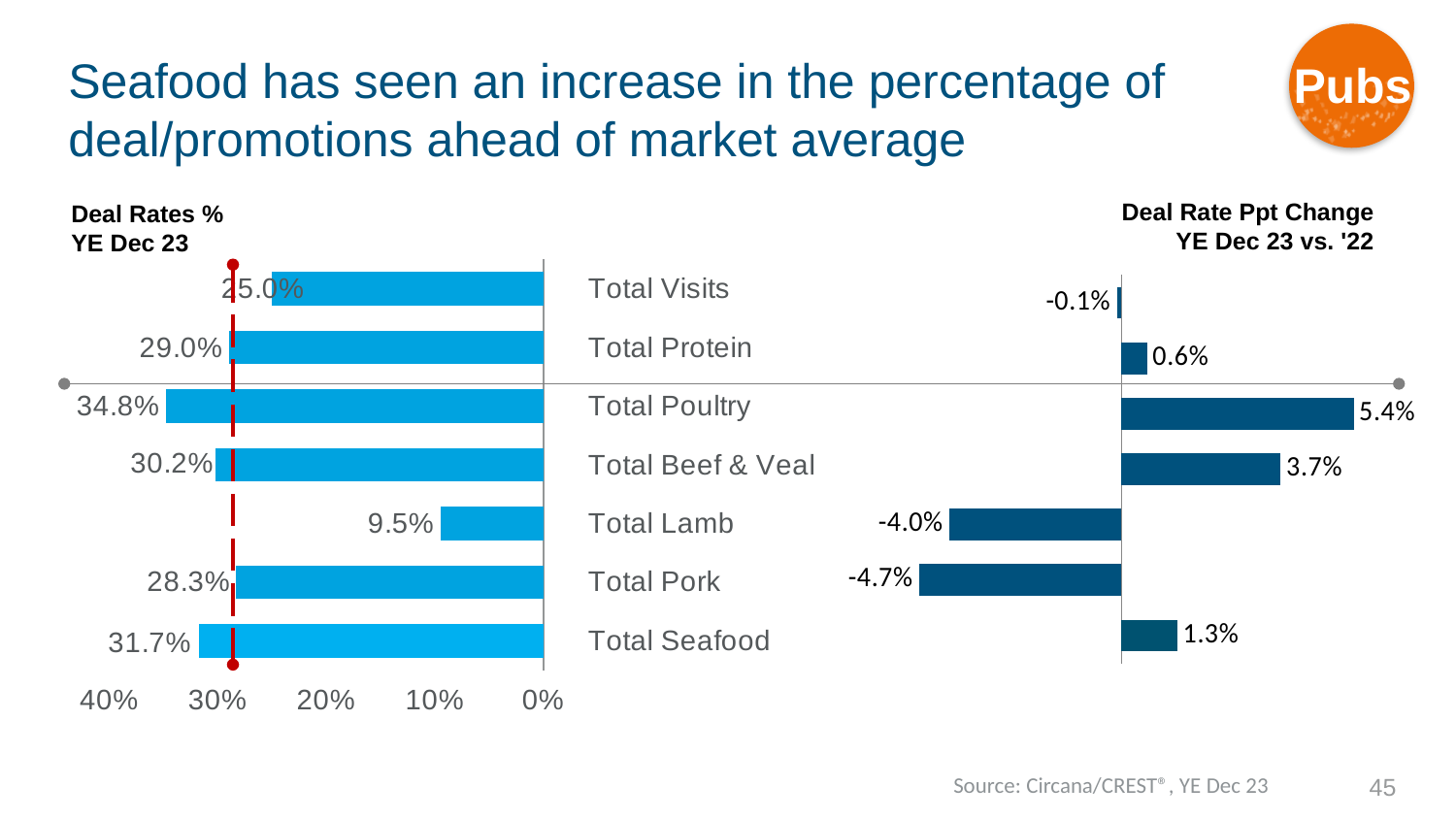
In the Deal Rates % YE Dec 23 chart, what is the value for Total Lamb? 9.5% How many categories are shown in the Deal Rates % YE Dec 23 chart? 7 In the Deal Rates % YE Dec 23 chart, which category has the highest deal rate? Total Poultry In the Deal Rate Ppt Change YE Dec 23 vs. '22 chart, which is larger, the change for Total Beef & Veal or Total Seafood? Total Beef & Veal In the Deal Rate Ppt Change YE Dec 23 vs. '22 chart, which category has the lowest change? Total Pork In the Deal Rate Ppt Change YE Dec 23 vs. '22 chart, which category has the largest change? Total Poultry In the Deal Rate Ppt Change YE Dec 23 vs. '22 chart, what is the value for Total Seafood? 1.3% In the Deal Rates % YE Dec 23 chart, what is the difference between Total Poultry and Total Visits? 9.8% In the Deal Rates % YE Dec 23 chart, what is the value for Total Seafood? 31.7% In the Deal Rates % YE Dec 23 chart, which category has the lowest deal rate? Total Lamb In the Deal Rate Ppt Change YE Dec 23 vs. '22 chart, what is the value for Total Pork? -4.7% What type of chart is the Deal Rates % YE Dec 23 chart? Bar chart